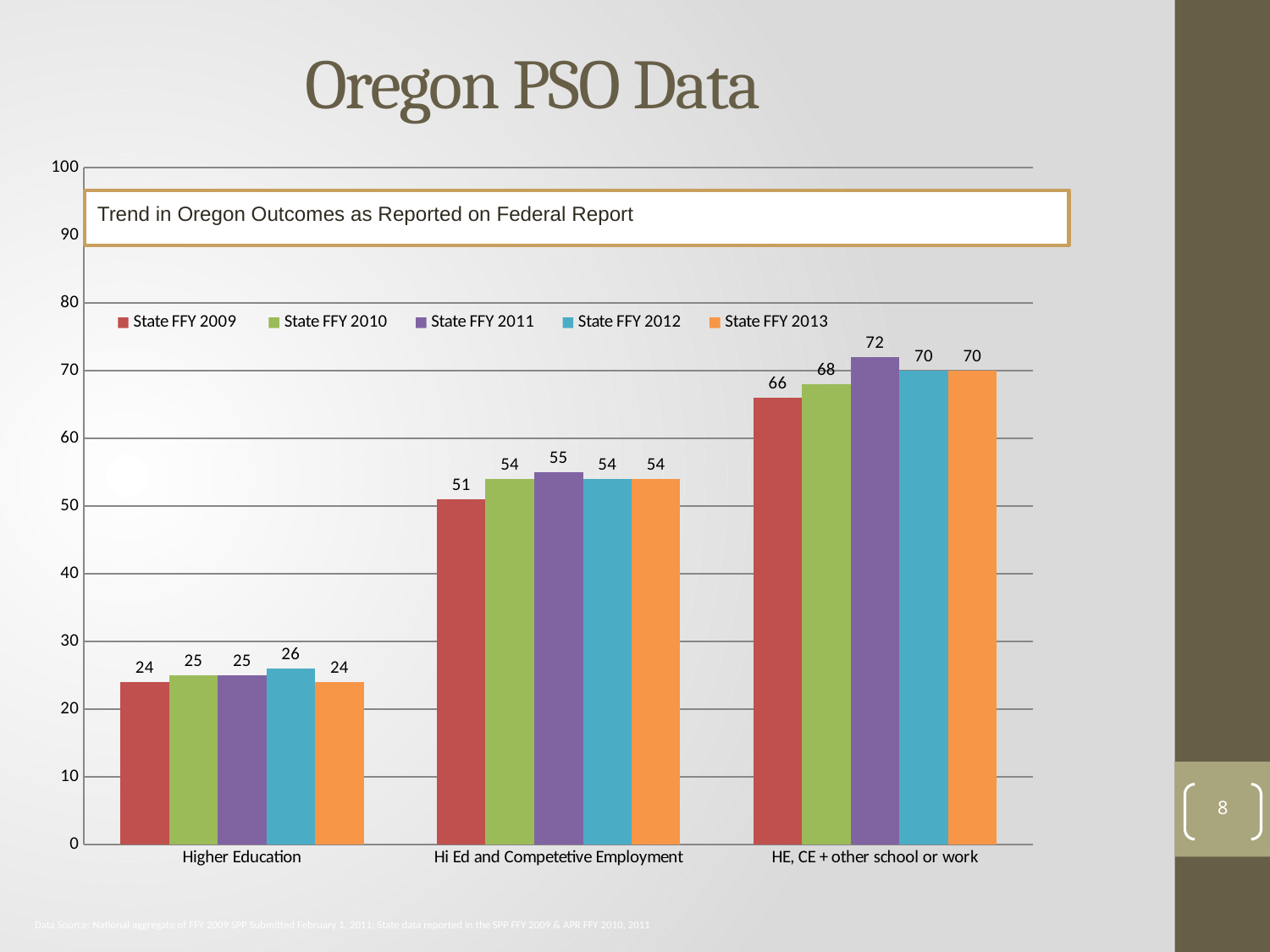
What is the difference between the State FFY 2011 and State FFY 2009 values in the HE, CE + other school or work category? 6 What is the value for State FFY 2012 in the Higher Education category? 26 What kind of chart is shown on the slide? bar chart Which series has the highest value in the HE, CE + other school or work category? State FFY 2011 How many series does the legend list? 5 Is the value for State FFY 2010 in the Hi Ed and Competetive Employment category greater or less than 50? greater How many categories are shown on the x axis? 3 What is the value for State FFY 2009 in the HE, CE + other school or work category? 66 Which series has the lowest value in the Hi Ed and Competetive Employment category? State FFY 2009 What is the title shown in the box inside the chart? Trend in Oregon Outcomes as Reported on Federal Report Which is larger in the Higher Education category: State FFY 2012 or State FFY 2013? State FFY 2012 What is the value for State FFY 2011 in the Hi Ed and Competetive Employment category? 55